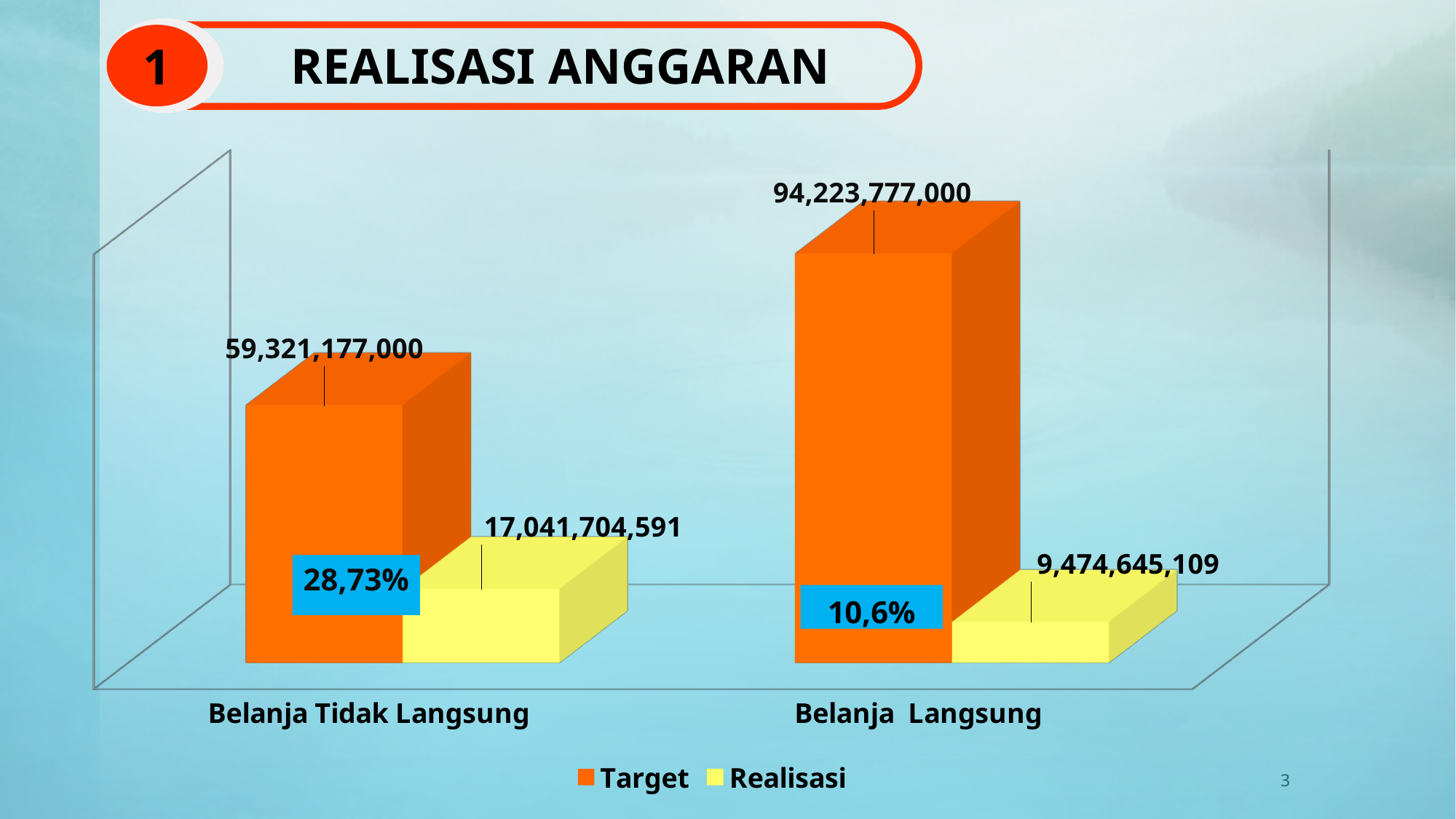
What is the Realisasi value for Belanja Tidak Langsung? 17,041,704,591 Which is larger: the Realisasi value for Belanja Tidak Langsung or the Realisasi value for Belanja Langsung? Belanja Tidak Langsung What is the difference between the Target and Realisasi values for Belanja Tidak Langsung? 42,279,472,409 Which category has the highest Target value? Belanja Langsung What is the Realisasi value for Belanja Langsung? 9,474,645,109 How many categories are shown on the x axis? 2 How many series does the legend list? 2 What kind of chart is shown on the slide? Bar chart What is the difference between the Target values for Belanja Langsung and Belanja Tidak Langsung? 34,902,600,000 What is the Target value for Belanja Langsung? 94,223,777,000 Which category has the lowest Realisasi value? Belanja Langsung What is the Target value for Belanja Tidak Langsung? 59,321,177,000